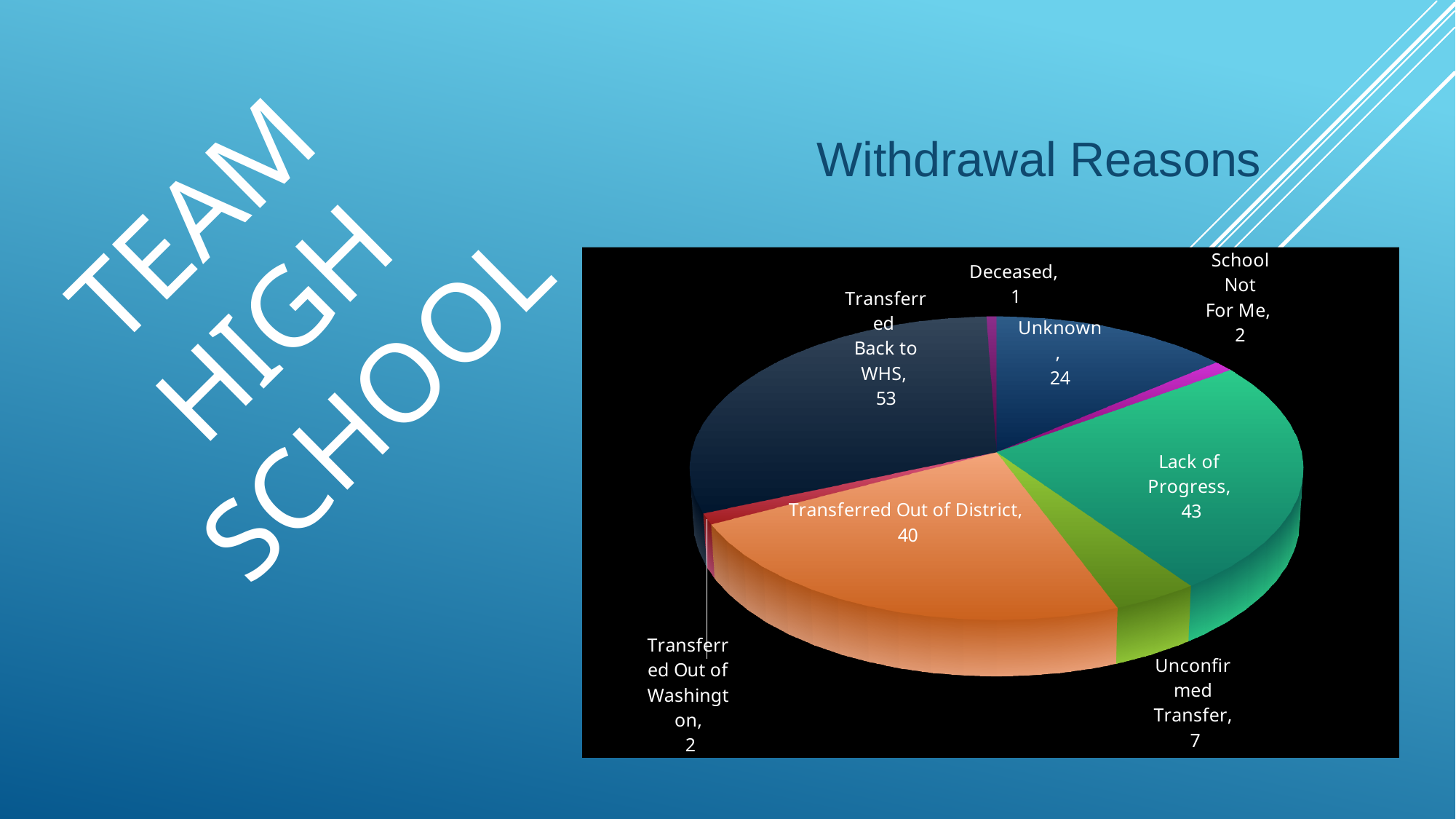
What is the value for Lack of Progress in the Withdrawal Reasons chart? 43 Which withdrawal reason has the highest value? Transferred Back to WHS What is the value for Transferred Back to WHS in the Withdrawal Reasons chart? 53 What kind of chart is shown on the slide? Pie chart What is the value for Unconfirmed Transfer in the Withdrawal Reasons chart? 7 What is the title of the chart on the slide? Withdrawal Reasons How many categories are shown in the Withdrawal Reasons pie chart? 8 What is the difference between Transferred Back to WHS and Transferred Out of District? 13 What is the value for Unknown in the Withdrawal Reasons chart? 24 Which withdrawal reason has the lowest value? Deceased Which is larger, Lack of Progress or Unknown? Lack of Progress What share of the total does Lack of Progress represent? 25%